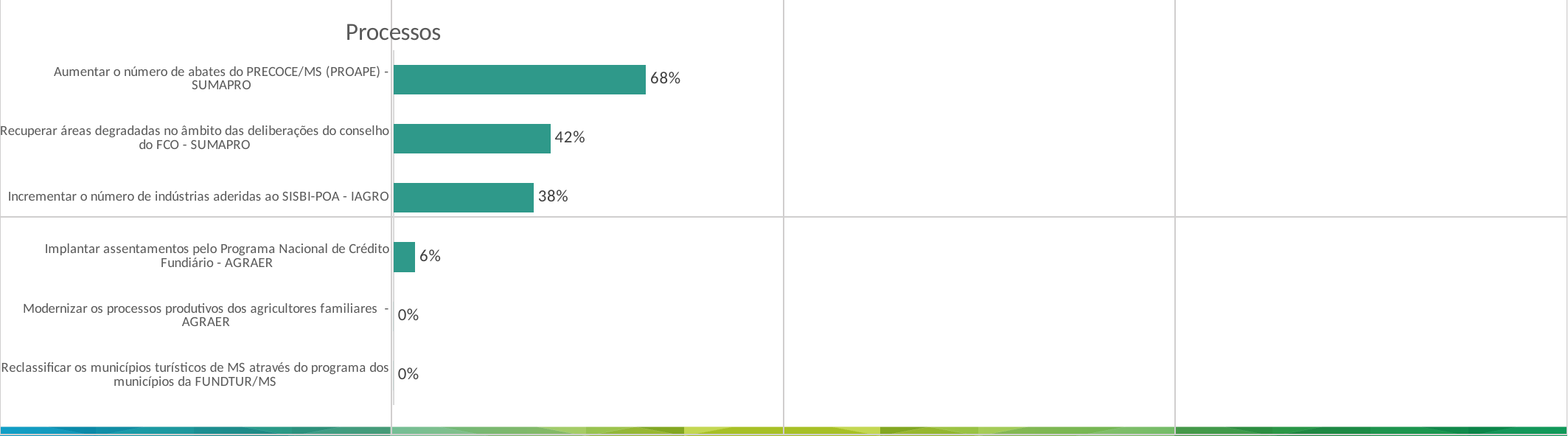
Which category has the highest value? Aumentar o número de abates do PRECOCE/MS (PROAPE) - SUMAPRO What is the value for 'Modernizar os processos produtivos dos agricultores familiares - AGRAER'? 0% What kind of chart is this? Bar chart What is the value for 'Implantar assentamentos pelo Programa Nacional de Crédito Fundiário - AGRAER'? 6% What is the difference between the values for 'Aumentar o número de abates do PRECOCE/MS (PROAPE) - SUMAPRO' and 'Recuperar áreas degradadas no âmbito das deliberações do conselho do FCO - SUMAPRO'? 26% What is the value for 'Incrementar o número de indústrias aderidas ao SISBI-POA - IAGRO'? 38% What is the title of the chart? Processos Which is larger: the value for 'Incrementar o número de indústrias aderidas ao SISBI-POA - IAGRO' or the value for 'Implantar assentamentos pelo Programa Nacional de Crédito Fundiário - AGRAER'? Incrementar o número de indústrias aderidas ao SISBI-POA - IAGRO What is the value for 'Aumentar o número de abates do PRECOCE/MS (PROAPE) - SUMAPRO'? 68% What is the value for 'Recuperar áreas degradadas no âmbito das deliberações do conselho do FCO - SUMAPRO'? 42% How many categories are shown in the chart? 6 What is the difference between the values for 'Recuperar áreas degradadas no âmbito das deliberações do conselho do FCO - SUMAPRO' and 'Incrementar o número de indústrias aderidas ao SISBI-POA - IAGRO'? 4%